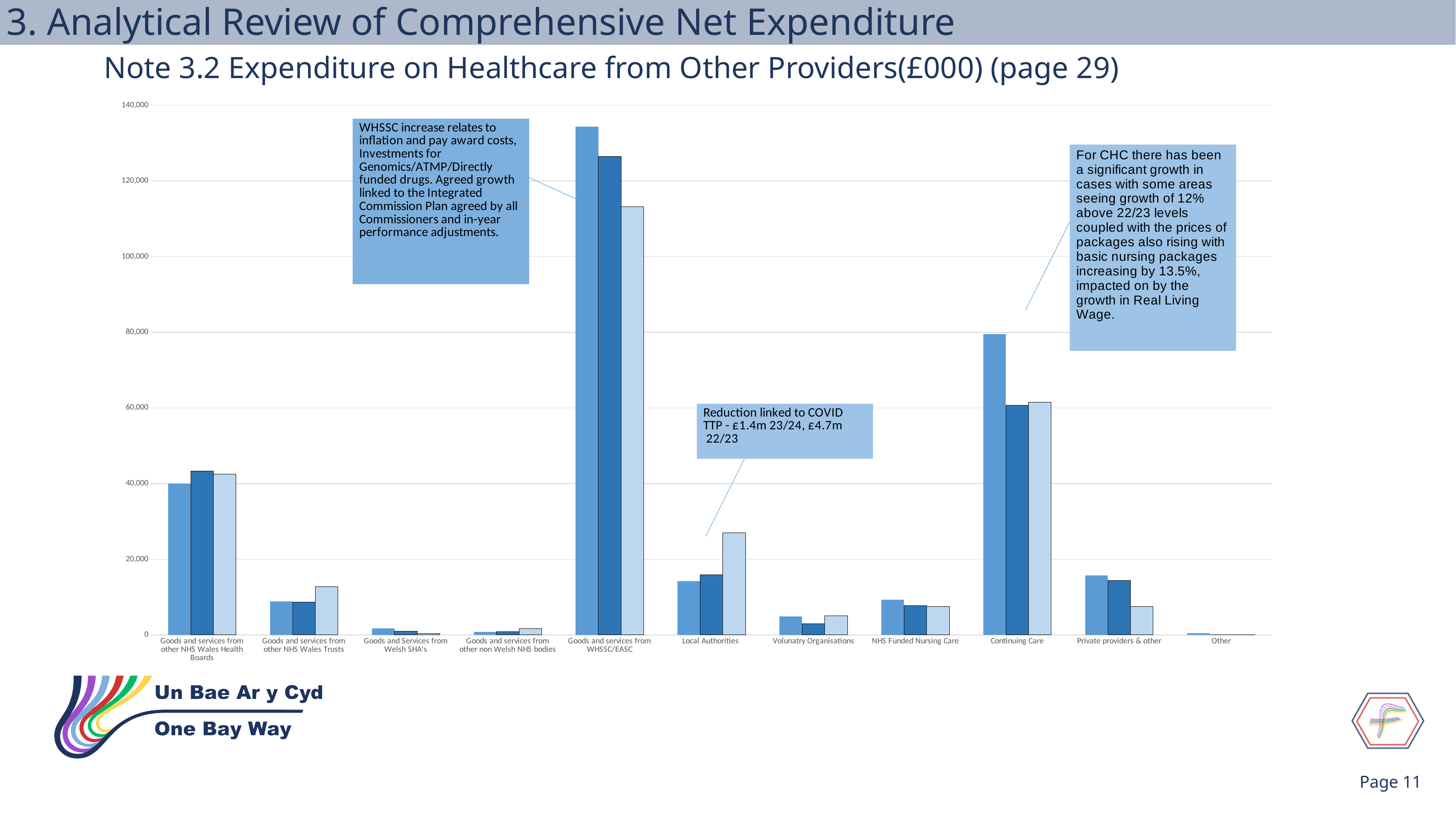
Which category has the tallest bars in the chart? Goods and services from WHSSC/EASC Is the tallest bar for Private providers & other greater or less than 20,000? less Which category has the smallest bars in the chart? Other Which category has taller bars: Continuing Care or Local Authorities? Continuing Care Which category has taller bars: Goods and services from WHSSC/EASC or Continuing Care? Goods and services from WHSSC/EASC Is the tallest bar for Goods and services from WHSSC/EASC greater or less than 120,000? greater What is the title of the chart on the slide? Note 3.2 Expenditure on Healthcare from Other Providers(£000) (page 29) What kind of chart is shown on the slide? Bar chart According to the annotation on the chart, what is the reduction for Local Authorities linked to? COVID TTP Is the tallest bar for Local Authorities greater or less than 20,000? greater How many categories are shown along the x axis of the chart? 11